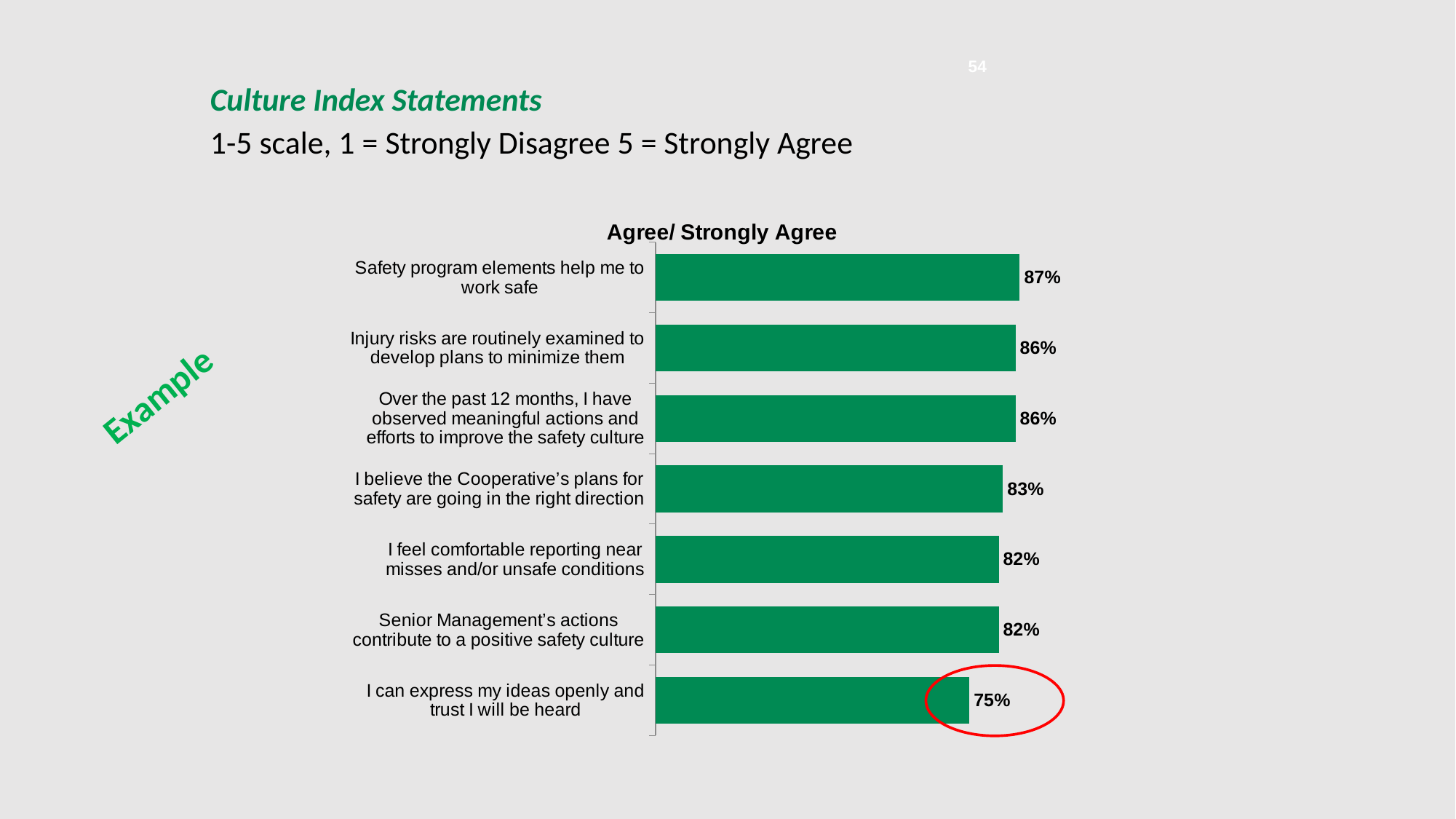
How many statements are shown on the chart? 7 What is the difference between the value for "I believe the Cooperative's plans for safety are going in the right direction" and "I feel comfortable reporting near misses and/or unsafe conditions"? 1% What is the value for "I can express my ideas openly and trust I will be heard"? 75% What kind of chart is shown on the slide? Bar chart What is the difference between the highest value (87%) and the lowest value (75%) on the chart? 12% Which statement has the highest Agree/Strongly Agree percentage? Safety program elements help me to work safe What percentage agree or strongly agree that safety program elements help them work safe? 87% What is the title of the chart? Agree/ Strongly Agree What percentage agree or strongly agree that they believe the Cooperative's plans for safety are going in the right direction? 83% Which statement has the lowest Agree/Strongly Agree percentage? I can express my ideas openly and trust I will be heard Which is larger: the value for "Injury risks are routinely examined to develop plans to minimize them" or the value for "I can express my ideas openly and trust I will be heard"? Injury risks are routinely examined to develop plans to minimize them What is the value for "Senior Management's actions contribute to a positive safety culture"? 82%